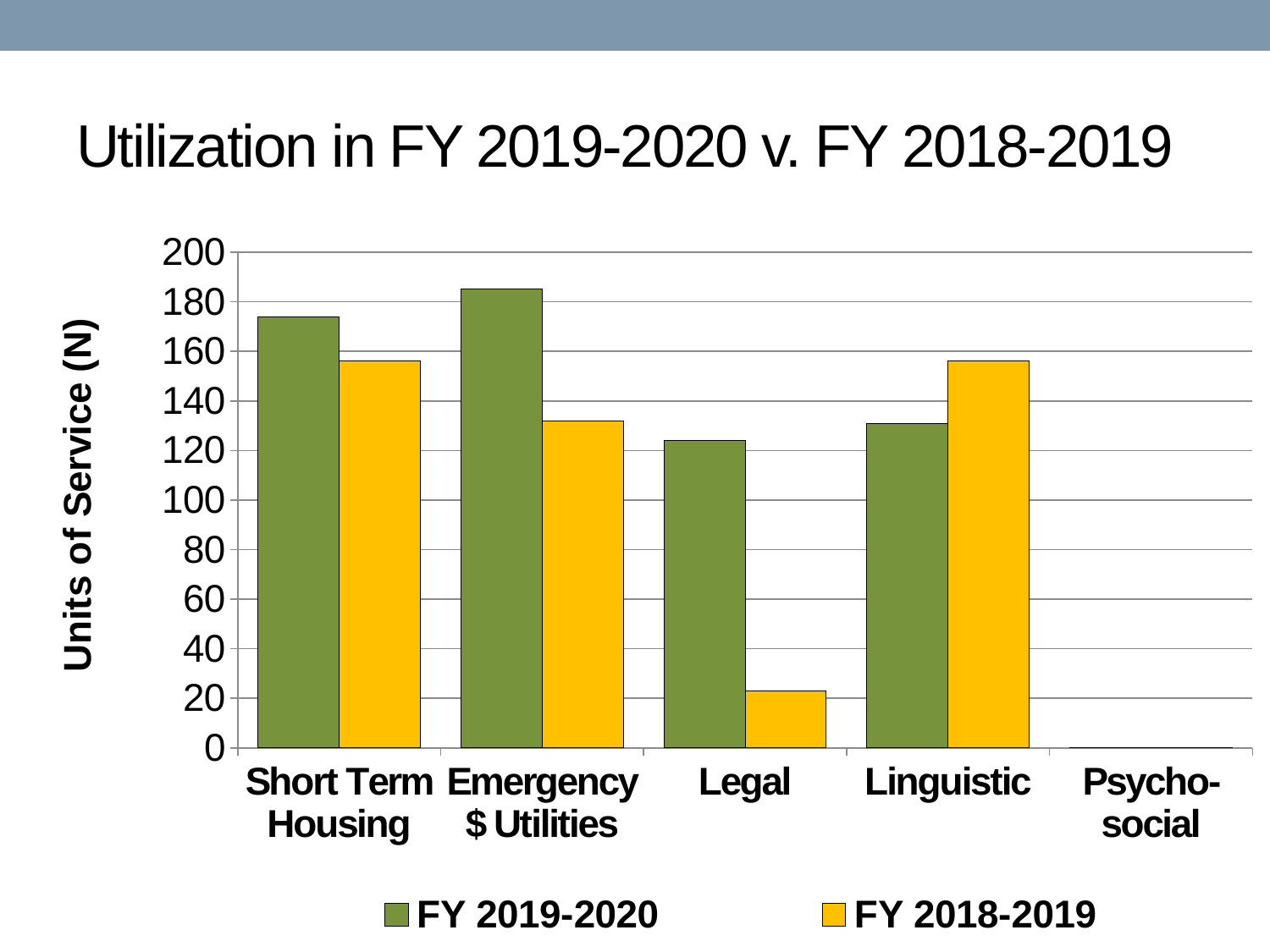
Which category has the lowest FY 2018-2019 value among those with a visible bar? Legal What kind of chart is shown on the slide? bar chart Is the FY 2019-2020 value for Short Term Housing greater or less than 160? greater Is the FY 2018-2019 value for Emergency $ Utilities greater or less than 140? less For Legal, which series has the larger value, FY 2019-2020 or FY 2018-2019? FY 2019-2020 How many series does the legend list? 2 How many categories are shown on the x axis? 5 Which category has the highest FY 2019-2020 value? Emergency $ Utilities What is the label of the vertical axis? Units of Service (N) For Linguistic, which series has the larger value, FY 2019-2020 or FY 2018-2019? FY 2018-2019 Is the FY 2019-2020 value for Emergency $ Utilities greater or less than 180? greater